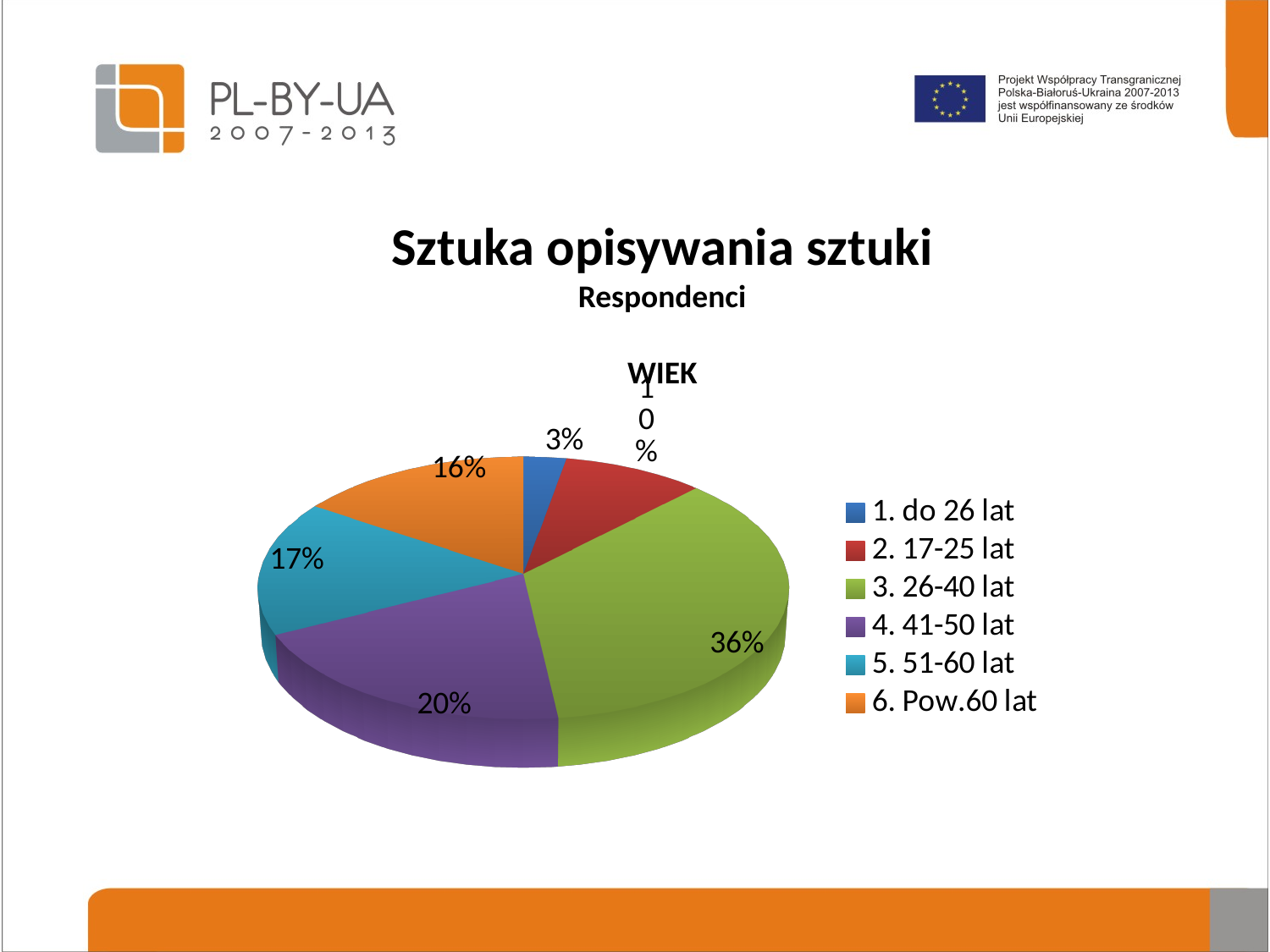
Which is larger, the share for 5. 51-60 lat or the share for 6. Pow.60 lat? 5. 51-60 lat How many slices does the pie chart have? 6 What is the chart's title? WIEK Which category has the smallest share of the pie? 1. do 26 lat How many entries does the legend list? 6 What percentage is shown for the category 1. do 26 lat? 3% What percentage is shown for the category 3. 26-40 lat? 36% What is the difference in percentage points between 3. 26-40 lat and 4. 41-50 lat? 16 What percentage is shown for the category 4. 41-50 lat? 20% Which category has the largest share of the pie? 3. 26-40 lat What percentage is shown for the category 6. Pow.60 lat? 16% What kind of chart is shown under the heading WIEK? pie chart